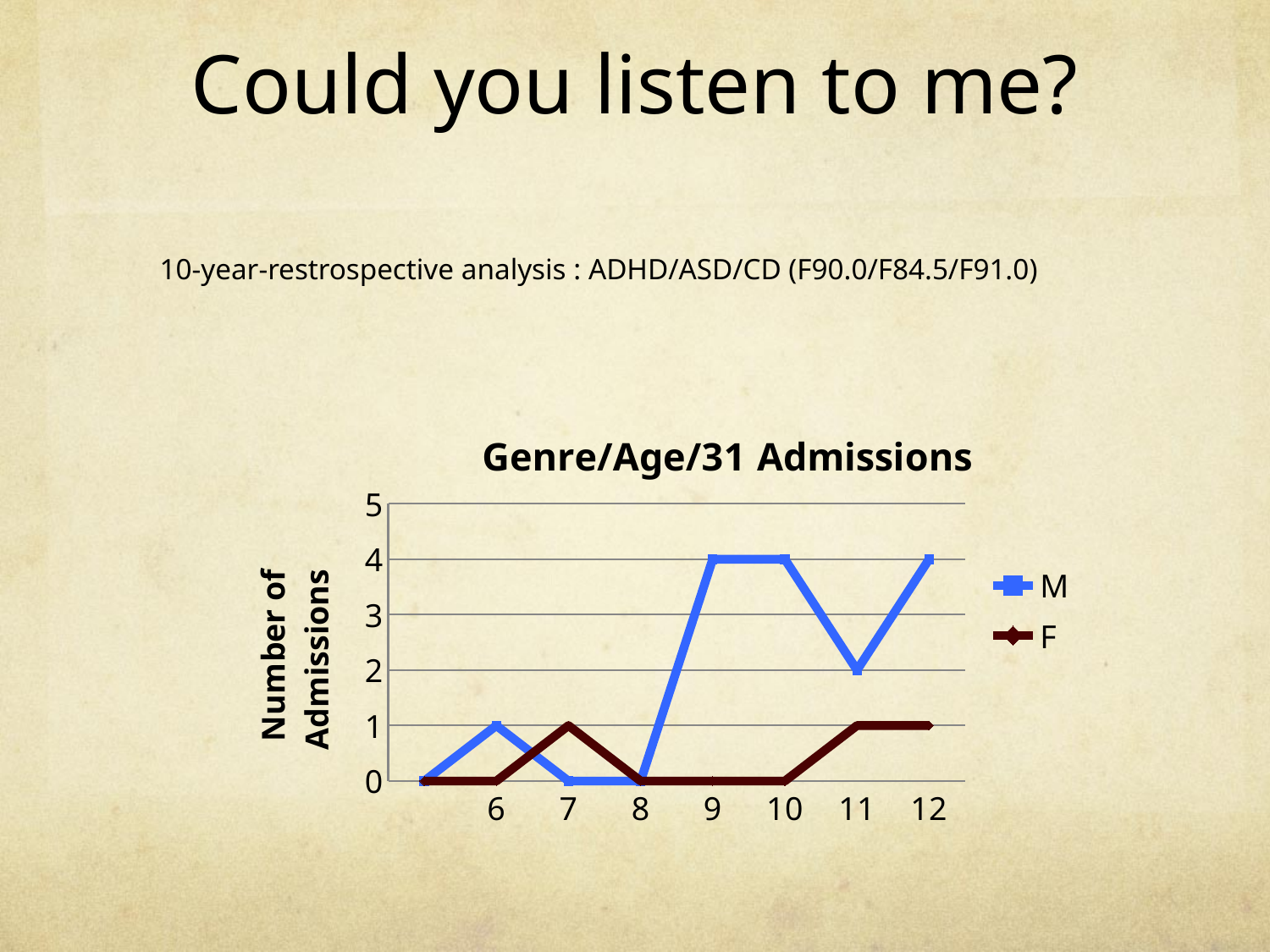
What is the label on the vertical axis of the chart? Number of Admissions What is the number of admissions for M at age 9? 4 What is the number of admissions for M at age 12? 4 What is the number of admissions for M at age 11? 2 What is the title of the chart? Genre/Age/31 Admissions What is the number of admissions for F at age 10? 0 What is the number of admissions for F at age 7? 1 What kind of chart is shown on the slide? line chart What is the difference between M and F admissions at age 9? 4 How many series does the legend list? 2 Does the M line rise or fall from age 10 to age 11? fall At age 7, which series has the higher number of admissions, M or F? F